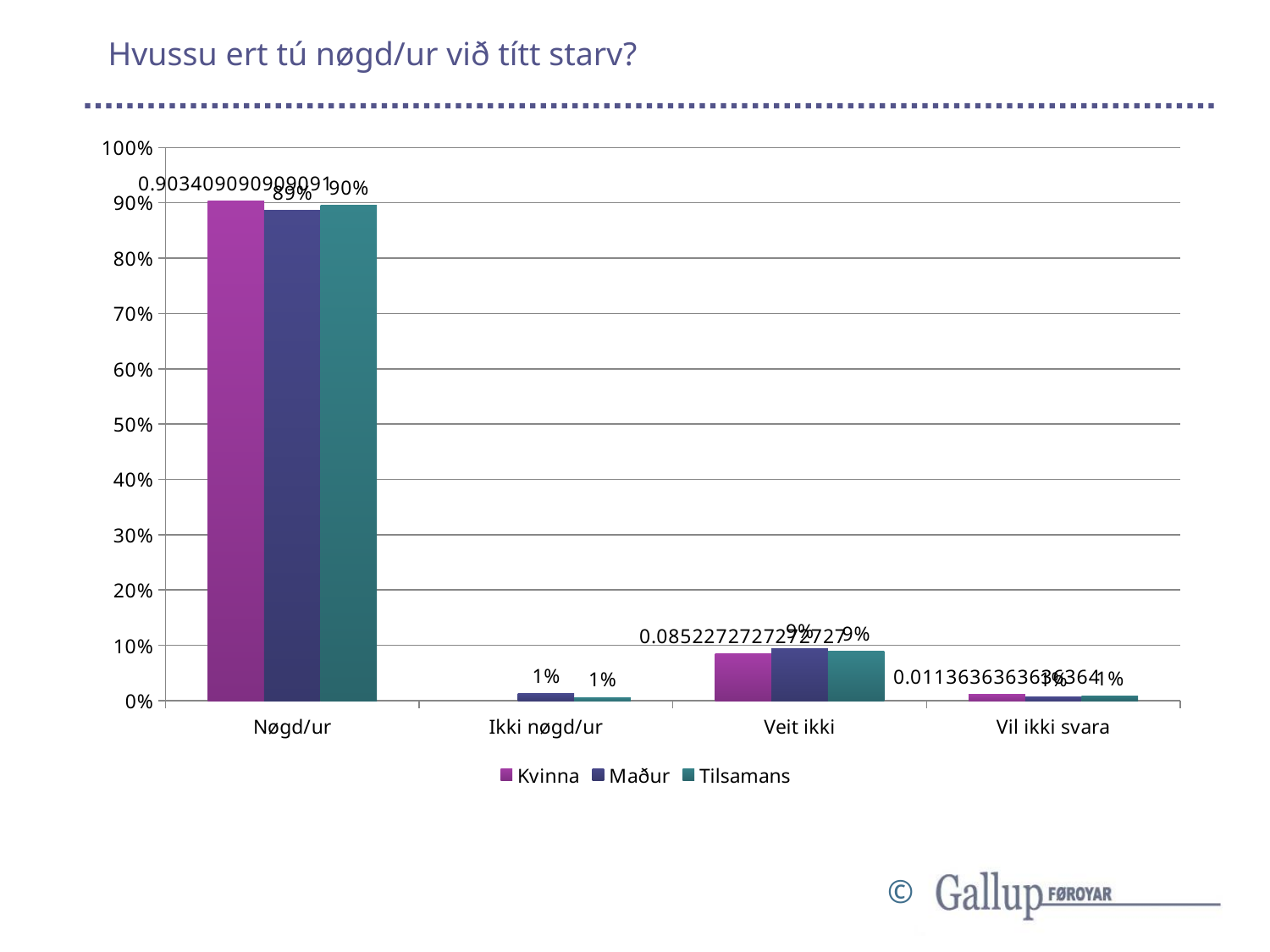
What is the value for Maður in the Nøgd/ur category? 89% What kind of chart is shown on the slide? bar chart What is the value for Tilsamans in the Veit ikki category? 9% How many series does the legend list? 3 Is the value for Kvinna in the Veit ikki category greater or less than 10%? less Which is larger for Tilsamans: Nøgd/ur or Veit ikki? Nøgd/ur What is the value for Tilsamans in the Nøgd/ur category? 90% Which category has the highest values across all series? Nøgd/ur Is the value for Kvinna in the Nøgd/ur category greater or less than 80%? greater What are the three series named in the legend? Kvinna, Maður, Tilsamans What is the difference between the Tilsamans and Maður values in the Nøgd/ur category? 1% How many categories are shown on the x axis? 4